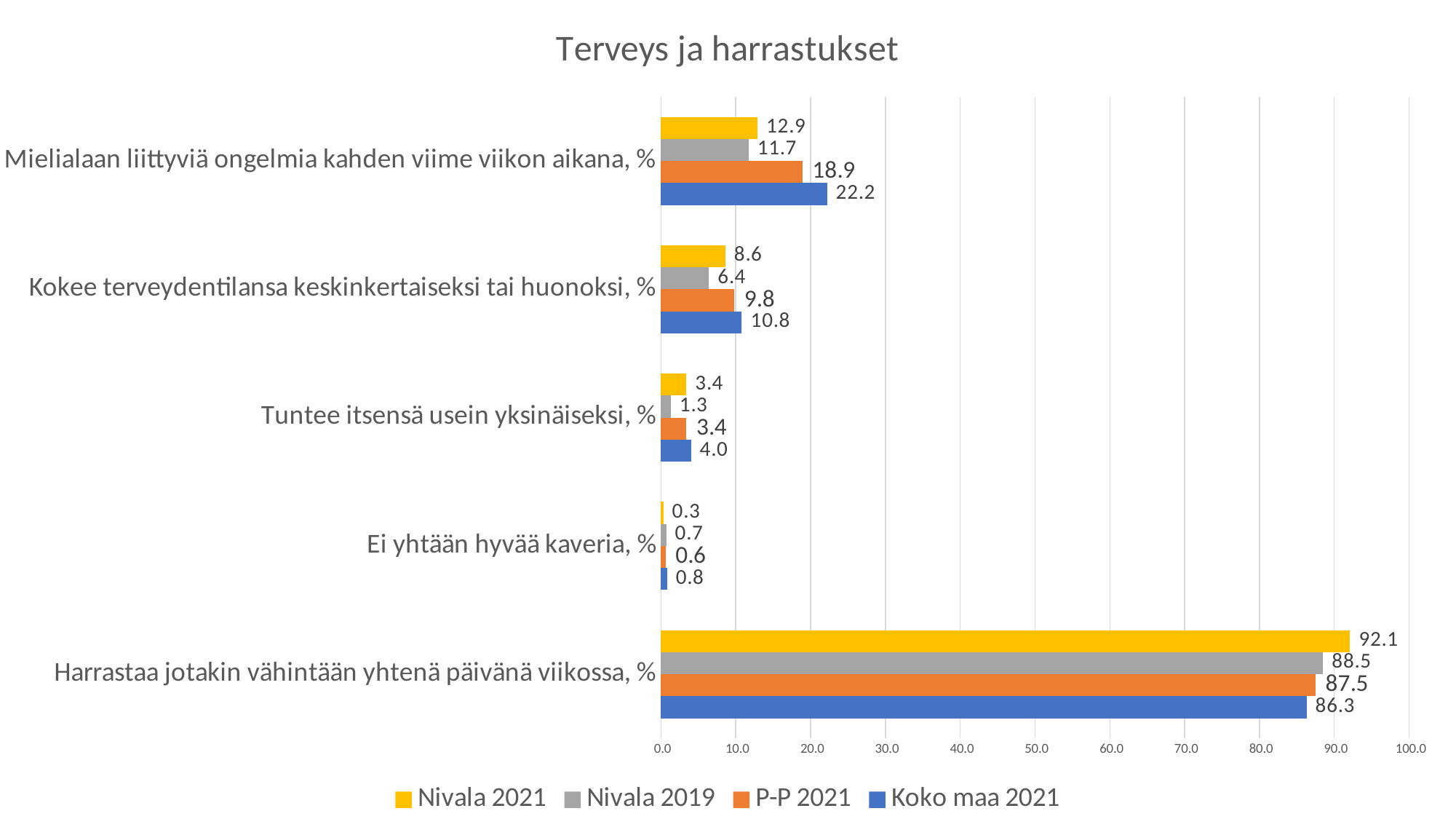
How many categories are shown on the chart? 5 Which series has the highest value in the category "Mielialaan liittyviä ongelmia kahden viime viikon aikana, %"? Koko maa 2021 What is the difference between the Nivala 2021 and Nivala 2019 values in the category "Harrastaa jotakin vähintään yhtenä päivänä viikossa, %"? 3.6 Which is larger in the category "Kokee terveydentilansa keskinkertaiseksi tai huonoksi, %": Nivala 2021 or Nivala 2019? Nivala 2021 Which series has the lowest value in the category "Ei yhtään hyvää kaveria, %"? Nivala 2021 What is the value for Koko maa 2021 in the category "Harrastaa jotakin vähintään yhtenä päivänä viikossa, %"? 86.3 How many series does the legend list? 4 What type of chart is shown on the slide? Bar chart What is the value for P-P 2021 in the category "Kokee terveydentilansa keskinkertaiseksi tai huonoksi, %"? 9.8 What is the value for Nivala 2019 in the category "Tuntee itsensä usein yksinäiseksi, %"? 1.3 What is the value for Nivala 2021 in the category "Mielialaan liittyviä ongelmia kahden viime viikon aikana, %"? 12.9 Is the value for Koko maa 2021 in the category "Mielialaan liittyviä ongelmia kahden viime viikon aikana, %" greater or less than 20.0? greater